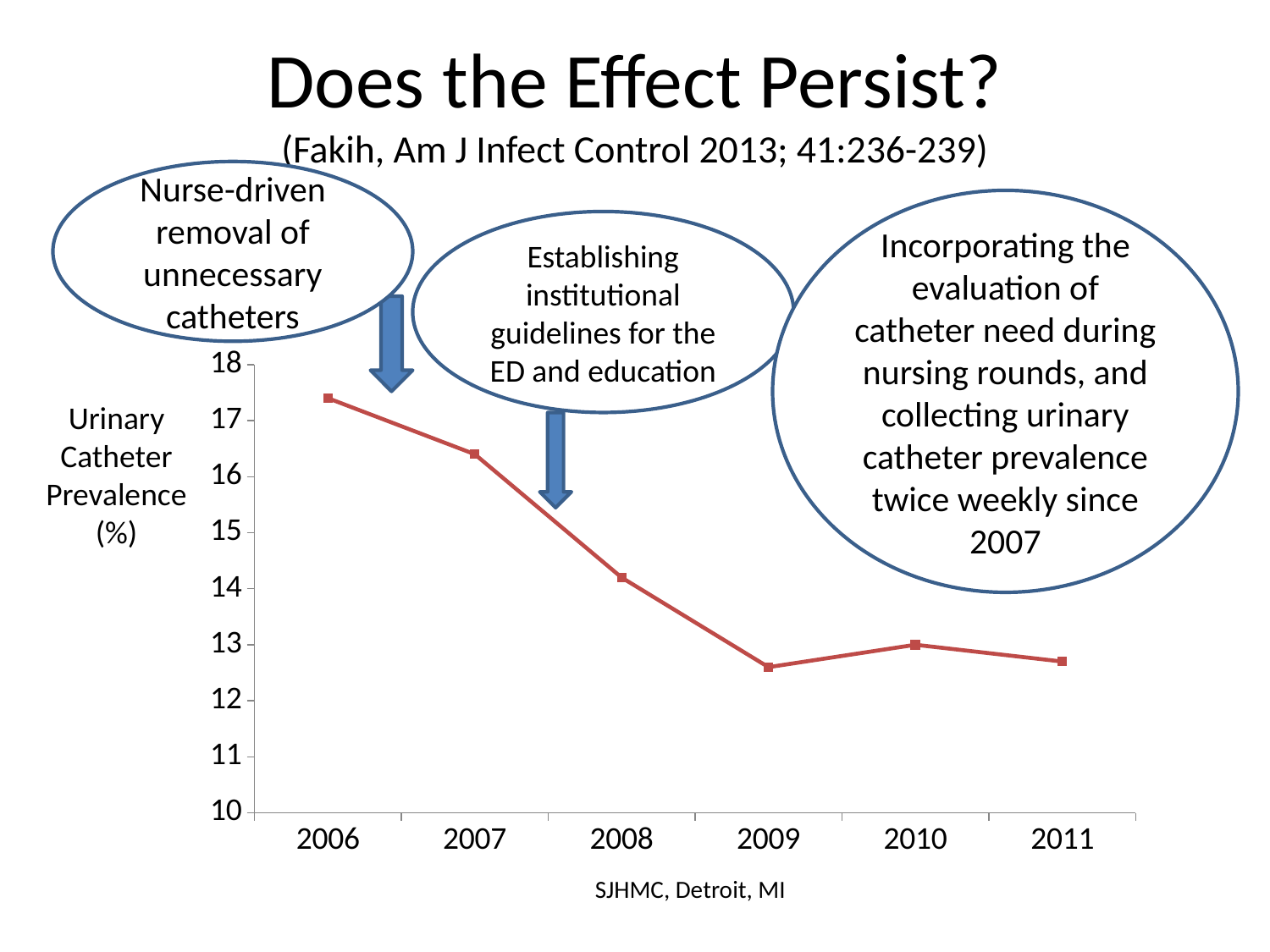
Is the value for 2011 greater or less than 13? less Which is larger, the value for 2008 or the value for 2010? 2008 How many data points are plotted on the line? 6 What institution and location are named below the chart? SJHMC, Detroit, MI Is the value for 2008 greater or less than 15? less Is the value for 2006 greater or less than 17? greater What is the label on the vertical axis of the chart? Urinary Catheter Prevalence (%) Does urinary catheter prevalence rise or fall from 2006 to 2009? fall What kind of chart is shown on the slide? line chart Which year has the highest urinary catheter prevalence? 2006